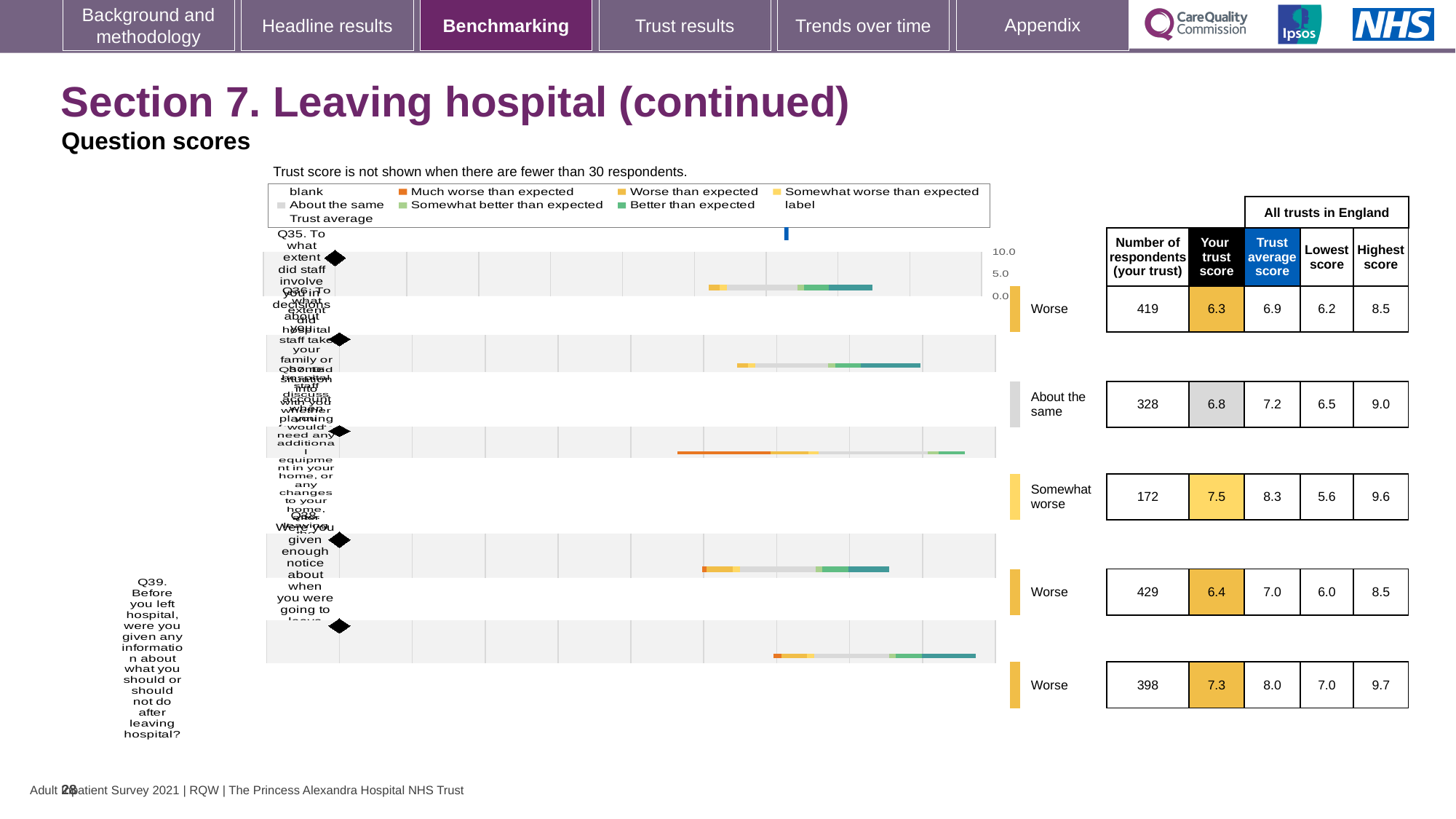
Which question has the lowest trust score? Q35 What is the difference between the trust average score and the trust score for Q37? 0.8 What is the lowest score across all trusts in England for Q37? 5.6 Which has the larger trust score, Q36 or Q38? Q36 How many questions (categories) are plotted in the question scores chart? 5 What is the highest score across all trusts in England for Q39? 9.7 Which benchmark category is Q36 assigned to? About the same What kind of chart is used to show the question scores on this slide? bar chart What is the trust score for Q35? 6.3 Is the trust score for Q35 greater or less than 5.0? greater Which question has the highest trust score? Q37 What is the number of respondents for Q38? 429